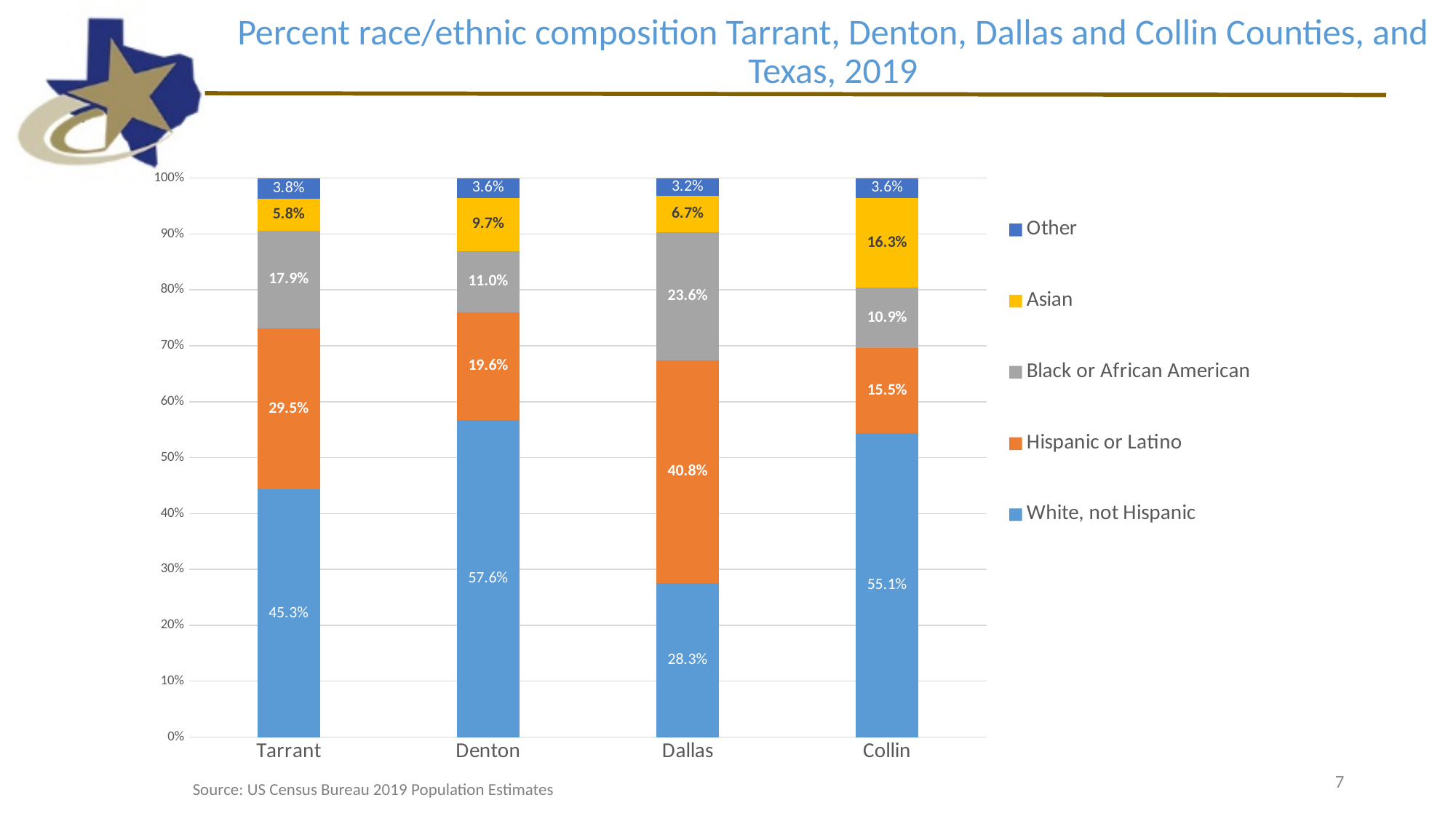
Which county has the lowest Other percentage? Dallas How many race/ethnic groups does the legend list? 5 Which county has the larger Asian percentage, Denton or Dallas? Denton Which county has the highest White, not Hispanic percentage? Denton What is the Hispanic or Latino percentage for Tarrant County? 29.5% What type of chart is shown on the slide? Stacked bar chart Which county has the highest Hispanic or Latino percentage? Dallas Which county has the lowest Asian percentage? Tarrant How many percentage points higher is the Black or African American share in Dallas than in Collin? 12.7 What is the White, not Hispanic percentage for Dallas County? 28.3% How many counties are shown on the x axis of the chart? 4 What is the Asian percentage for Collin County? 16.3%